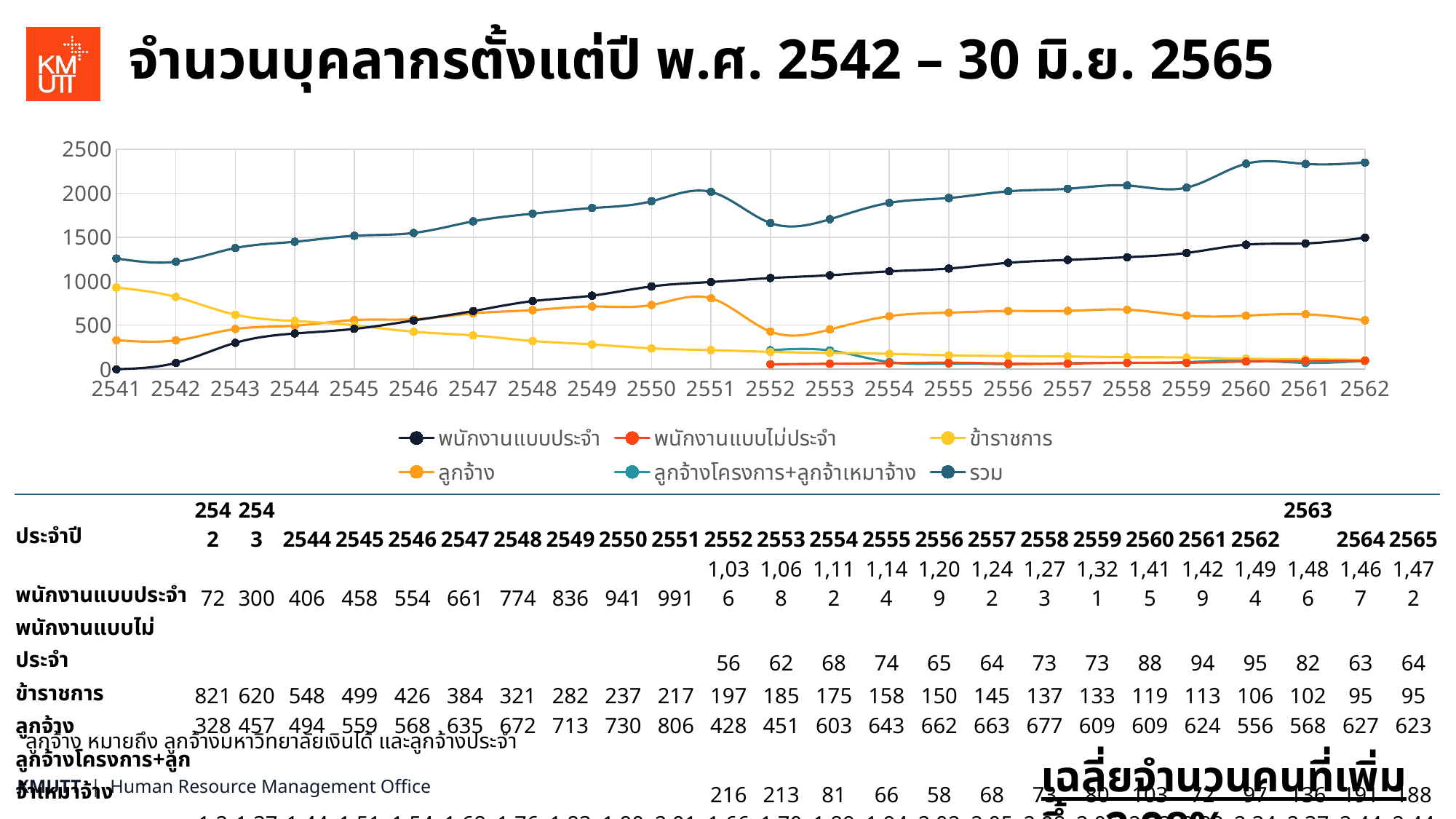
According to the table below the chart, what is the value of ลูกจ้าง for 2551? 806 Is the value of ข้าราชการ at 2542 greater or less than 500? greater According to the table below the chart, what is the value of ข้าราชการ for 2542? 821 How many year labels are shown along the x axis of the chart? 22 How many series does the chart legend list? 6 Does the รวม line generally rise or fall from 2541 to 2562? rise What kind of chart is shown on the slide? line chart Does the ข้าราชการ line rise or fall from 2542 to 2562? fall Is the value of พนักงานแบบประจำ at 2556 greater or less than 1000? greater Is the value of รวม at 2562 greater or less than 2000? greater At 2550, which is larger: ลูกจ้าง or ข้าราชการ? ลูกจ้าง Which series is the highest line on the chart at 2562? รวม